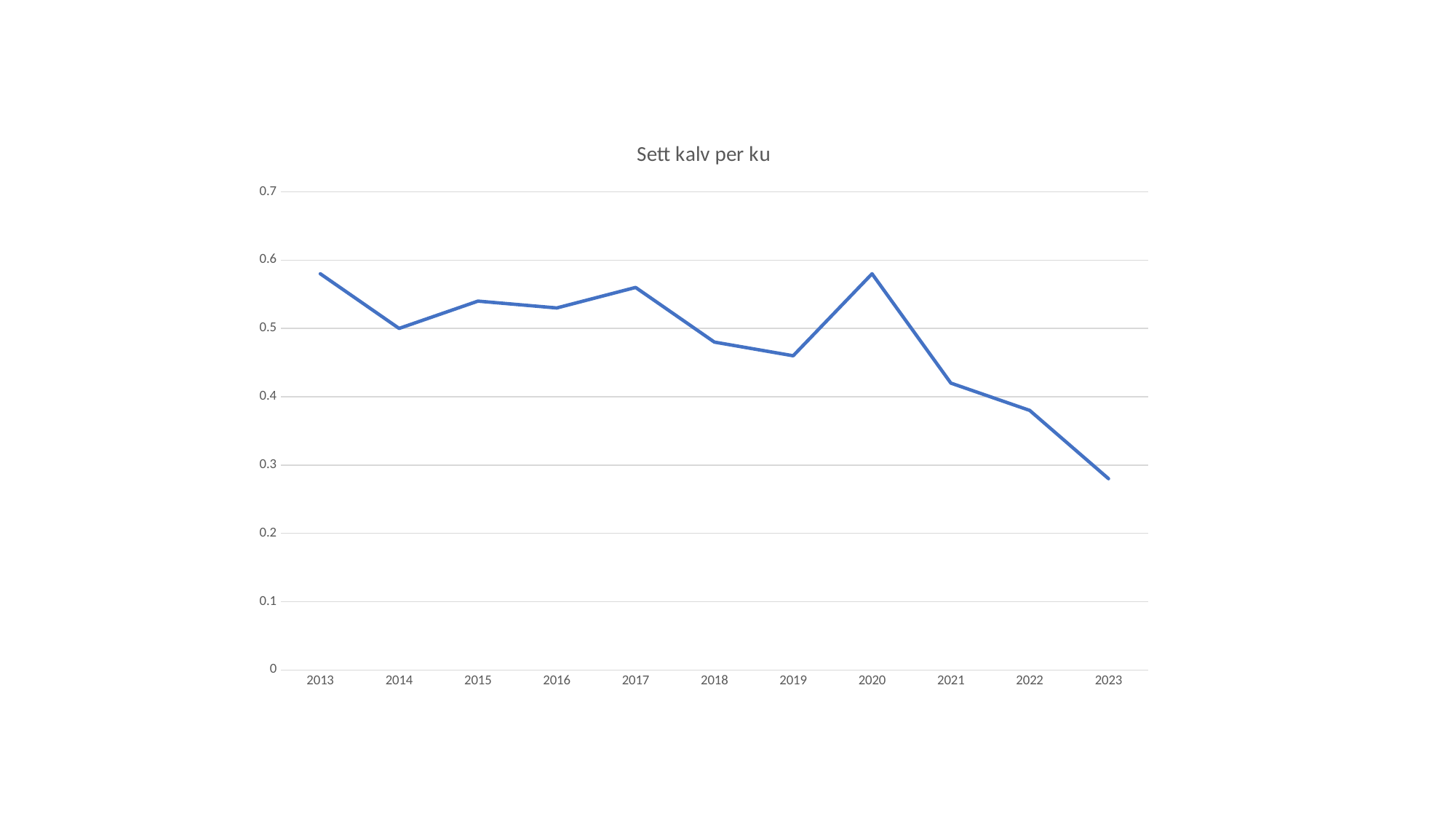
Which is larger, the value for 2020 or the value for 2021? 2020 Is the value for 2023 greater or less than 0.3? less What is the value for 2014? 0.5 How many years are plotted on the x axis? 11 What kind of chart is shown on the slide? line chart Which year has the lowest value? 2023 Is the value for 2022 greater or less than 0.4? less What is the title of the chart? Sett kalv per ku Is the value for 2021 greater or less than 0.5? less Do the values generally rise or fall from 2020 to 2023? fall Which is larger, the value for 2017 or the value for 2019? 2017